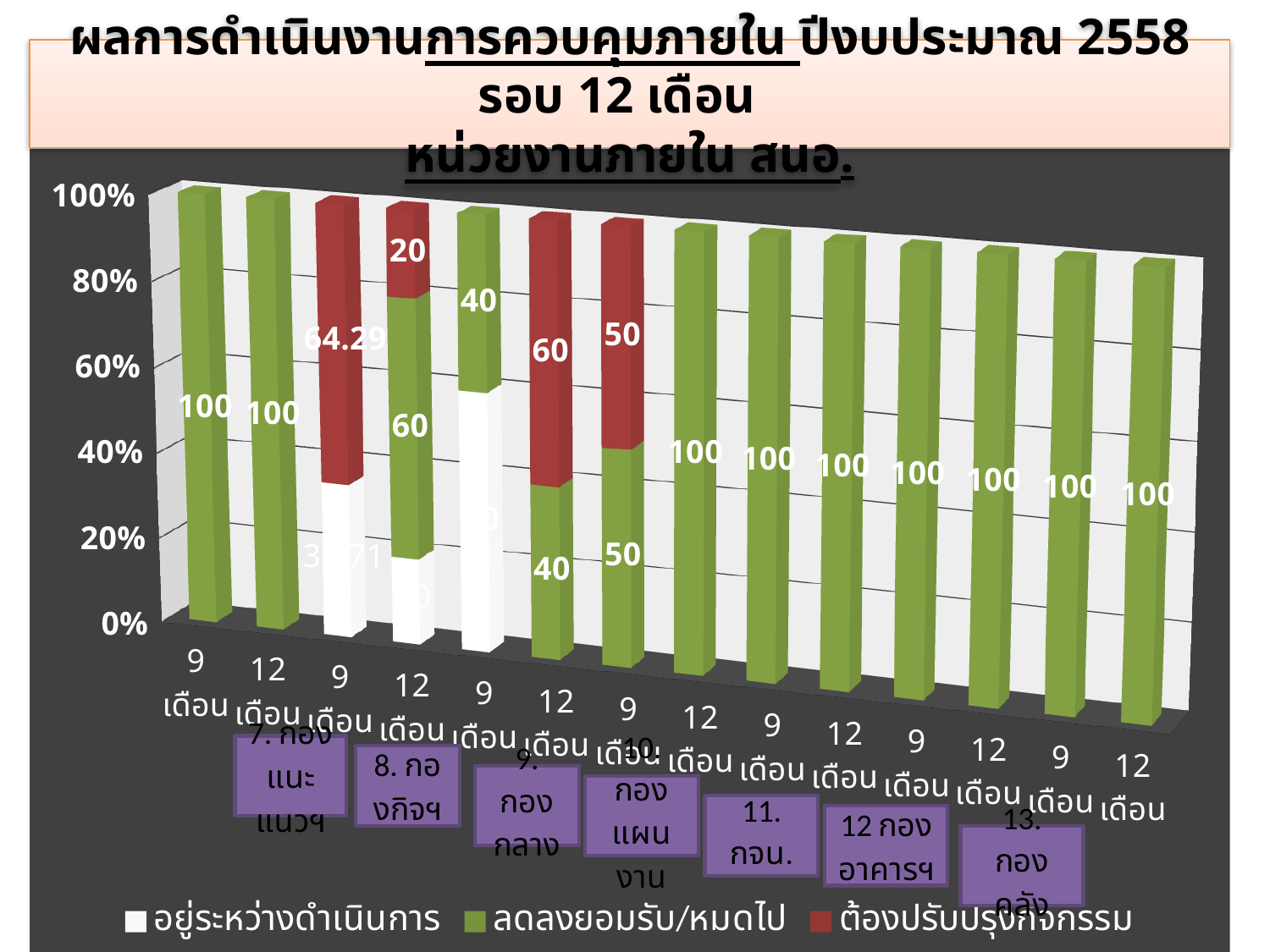
What kind of chart is shown on the slide? stacked bar chart How many bars are plotted in the chart? 14 What is the value of the red segment in the 12 เดือน bar for 9. กองกลาง? 60 What is the value of the green segment in the 12 เดือน bar for 9. กองกลาง? 40 What is the value of the red segment in the 12 เดือน bar for 8. กองกิจฯ? 20 In the 12 เดือน bar for 9. กองกลาง, which segment is larger, the green one or the red one? red What is the value of the green segment in the 9 เดือน bar for 11. กจน.? 100 What is the value of the red (ต้องปรับปรุงกิจกรรม) segment in the 9 เดือน bar for 8. กองกิจฯ? 64.29 How many series does the legend list? 3 What is the value of the green (ลดลงยอมรับ/หมดไป) segment in the 12 เดือน bar for 8. กองกิจฯ? 60 Which legend entry is shown in red? ต้องปรับปรุงกิจกรรม What is the value of the green segment in the 9 เดือน bar for 10. กองแผนงาน? 50